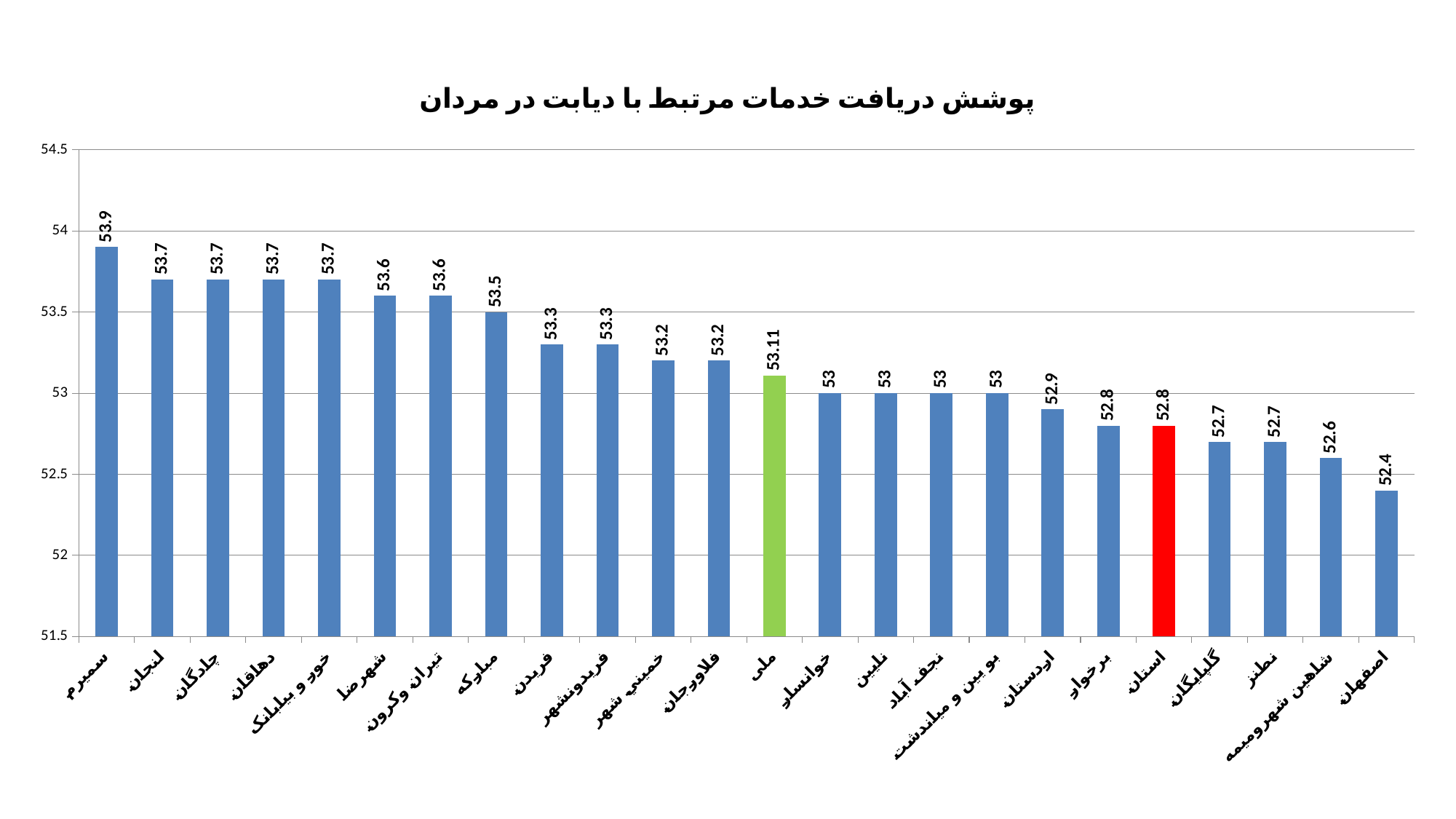
What is the value for سمیرم? 53.9 Which is larger, the value for مبارکه or the value for اردستان? مبارکه What is the title of the chart? پوشش دریافت خدمات مرتبط با دیابت در مردان How many bars are shown in the chart? 24 What is the value for the red bar labelled استان? 52.8 What kind of chart is shown on the slide? bar chart Which category has the lowest value? اصفهان What is the value for اصفهان? 52.4 Is the value for شاهین شهر و میمه greater or less than 53? less Which category has the highest value? سمیرم What is the difference between the values for سمیرم and اصفهان? 1.5 What is the value for the green bar labelled ملی? 53.11